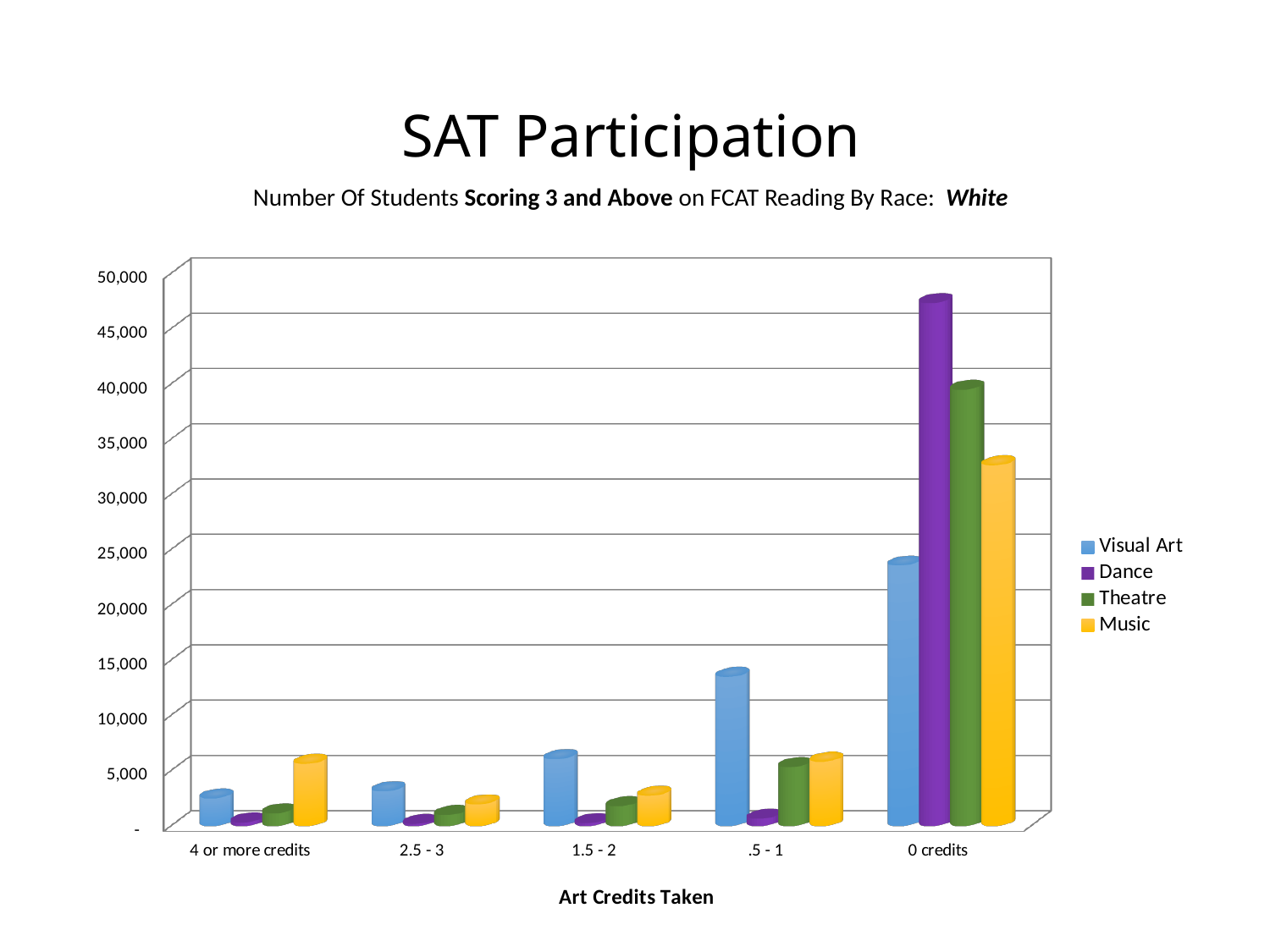
Which series has the highest bar in the 0 credits category? Dance Is the value for Music at 0 credits greater or less than 35,000? less Which series has the lowest bar in the 0 credits category? Visual Art Is the value for Dance at 0 credits greater or less than 45,000? greater How many categories are shown on the x axis of the chart? 5 How many series does the chart's legend list? 4 Which is larger in the 4 or more credits category, Music or Visual Art? Music Which is larger in the .5 - 1 category, Visual Art or Theatre? Visual Art Do the Visual Art values rise or fall moving from 4 or more credits to 0 credits along the x axis? rise What is the title of the x axis? Art Credits Taken What kind of chart is shown on the slide? bar chart Is the value for Visual Art at .5 - 1 credits greater or less than 10,000? greater